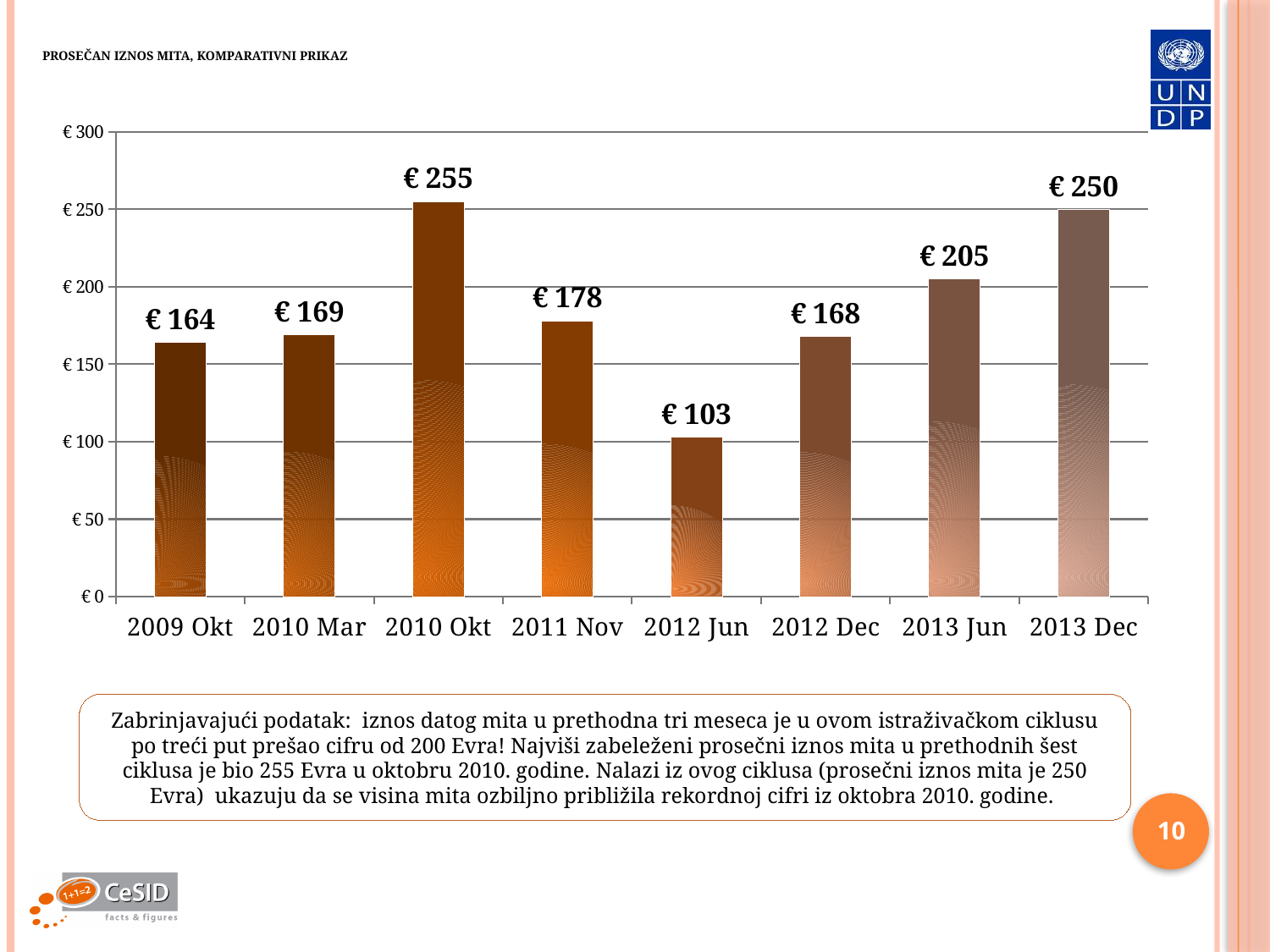
What value is shown for 2012 Jun? € 103 What kind of chart is shown on the slide? bar chart What value is shown for 2009 Okt? € 164 What is the average bribe amount shown for 2010 Okt? € 255 What is the difference between the values for 2013 Jun and 2012 Dec? € 37 Which is larger, the value for 2011 Nov or the value for 2012 Dec? 2011 Nov What is the difference between the values for 2010 Okt and 2013 Dec? € 5 Do the values rise or fall from 2012 Jun to 2013 Dec? rise What value is shown for 2013 Dec? € 250 Which period has the highest value? 2010 Okt Which period has the lowest value? 2012 Jun How many periods are shown on the x axis? 8